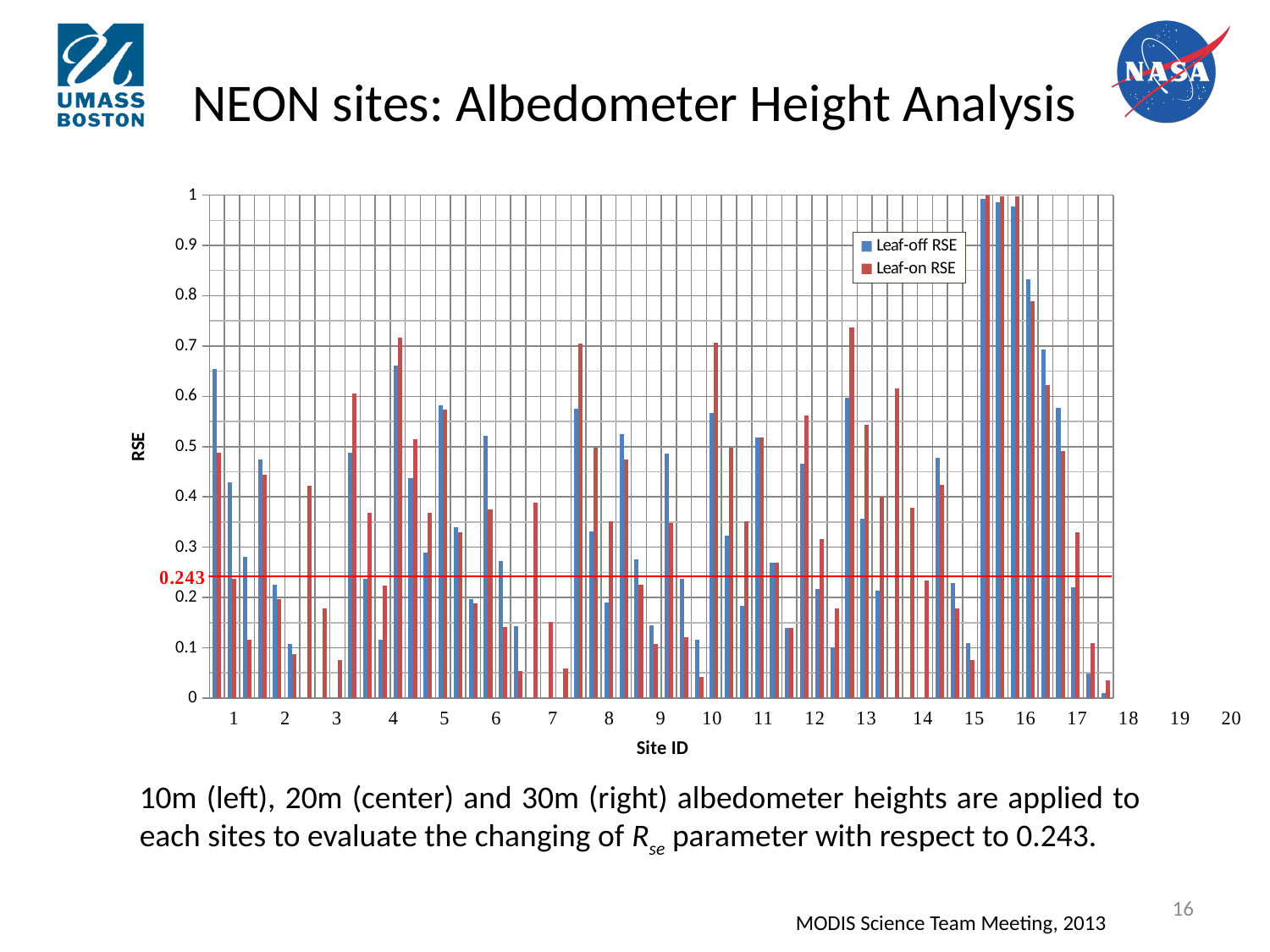
What kind of chart is shown on the slide? Bar chart Is the tallest bar at Site 2 greater or less than 0.5? less How many series does the chart legend list? 2 Is the tallest Leaf-on RSE bar at Site 13 greater or less than 0.6? greater What are the two series named in the chart legend? Leaf-off RSE and Leaf-on RSE Is the tallest bar at Site 9 greater or less than 0.6? less What value is marked by the red horizontal reference line on the chart? 0.243